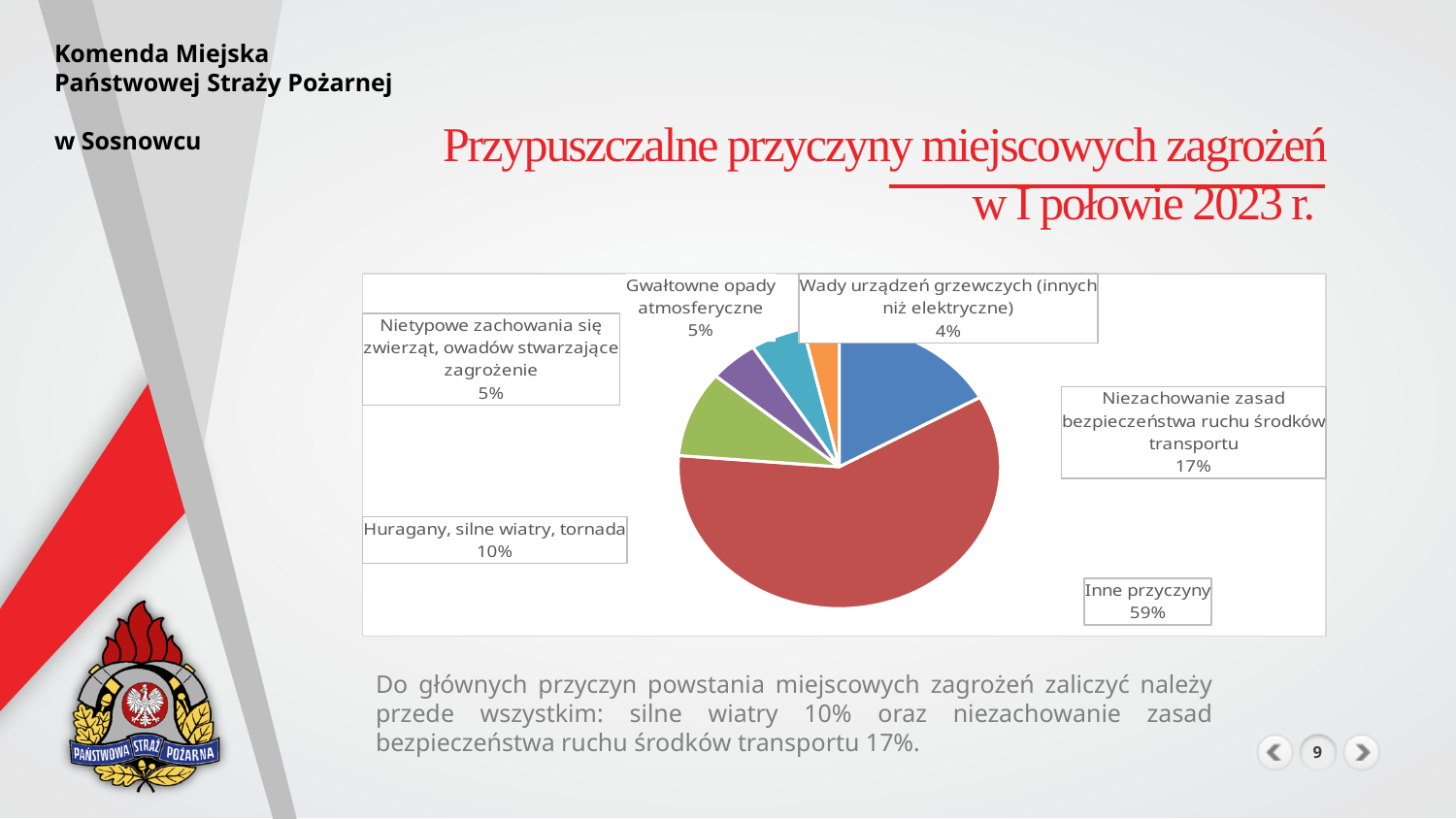
What percentage is shown for "Wady urządzeń grzewczych (innych niż elektryczne)"? 4% Which is larger: the share for "Huragany, silne wiatry, tornada" or the share for "Gwałtowne opady atmosferyczne"? Huragany, silne wiatry, tornada Which category has the smallest share of the pie? Wady urządzeń grzewczych (innych niż elektryczne) How many slices does the pie chart have? 6 What percentage is shown for "Huragany, silne wiatry, tornada"? 10% What share of the pie is labelled "Inne przyczyny"? 59% What is the difference in percentage points between "Niezachowanie zasad bezpieczeństwa ruchu środków transportu" and "Huragany, silne wiatry, tornada"? 7 percentage points Which category has the largest share of the pie? Inne przyczyny What percentage is shown for "Gwałtowne opady atmosferyczne"? 5% What percentage is shown for "Niezachowanie zasad bezpieczeństwa ruchu środków transportu"? 17% What is the title of the slide containing the chart? Przypuszczalne przyczyny miejscowych zagrożeń w I połowie 2023 r. What kind of chart is shown on the slide? pie chart